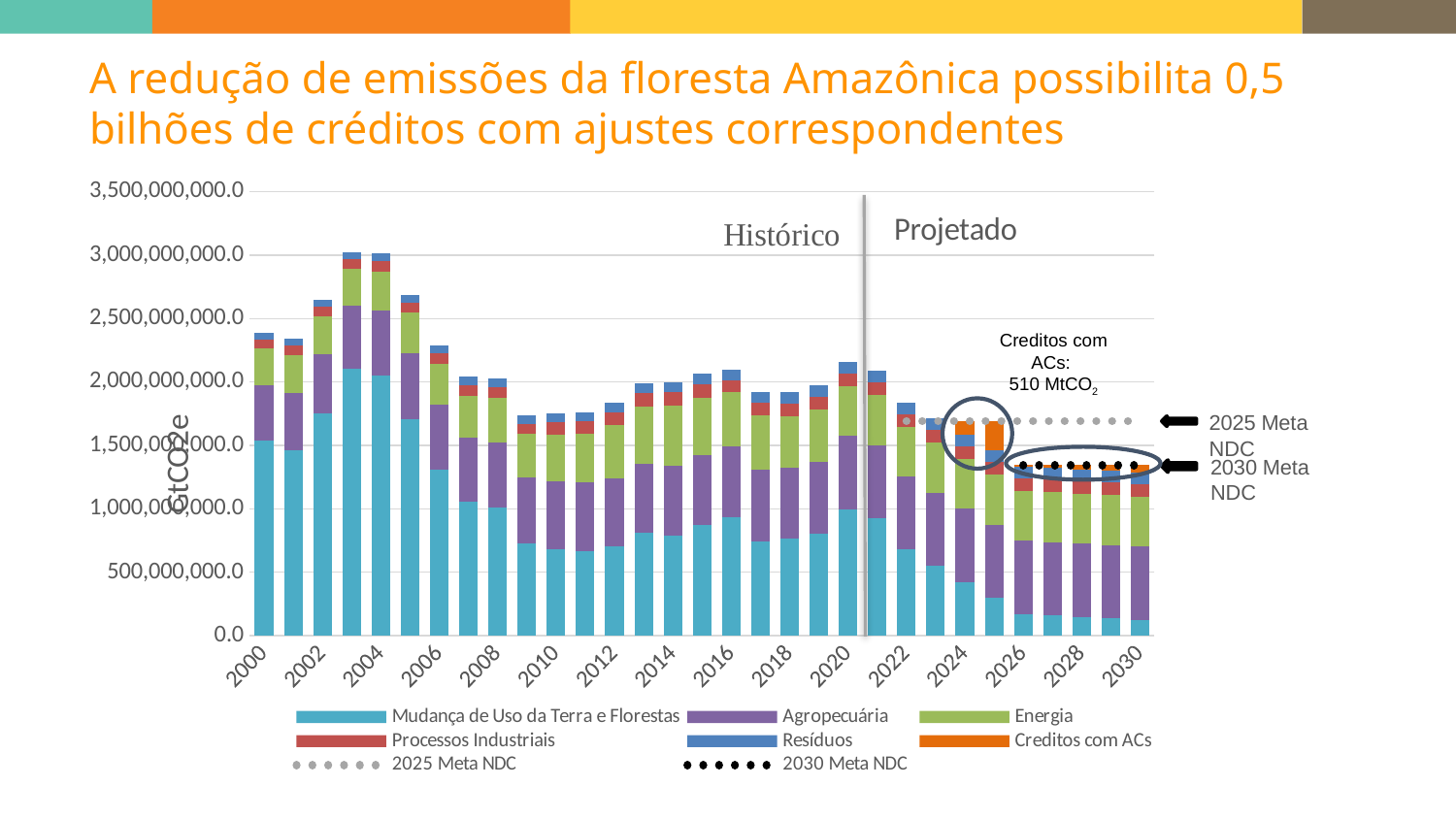
Which year has the larger total bar, 2004 or 2010? 2004 Which legend entry is shown in orange? Creditos com ACs Is the total emissions value for 2000 greater or less than 2,000,000,000.0? greater Is the total emissions value for 2030 greater or less than 1,500,000,000.0? less Is the total emissions value for 2010 greater or less than 2,000,000,000.0? less What amount of credits with ACs is annotated on the chart? 510 MtCO2 Do the total bar heights rise or fall from 2022 to 2030? fall What are the two labels that divide the chart into past and future periods? Histórico and Projetado How many entries does the chart legend list? 8 How many years (bars) are plotted along the x axis, from 2000 to 2030? 31 What kind of chart is shown on the slide? Stacked bar chart